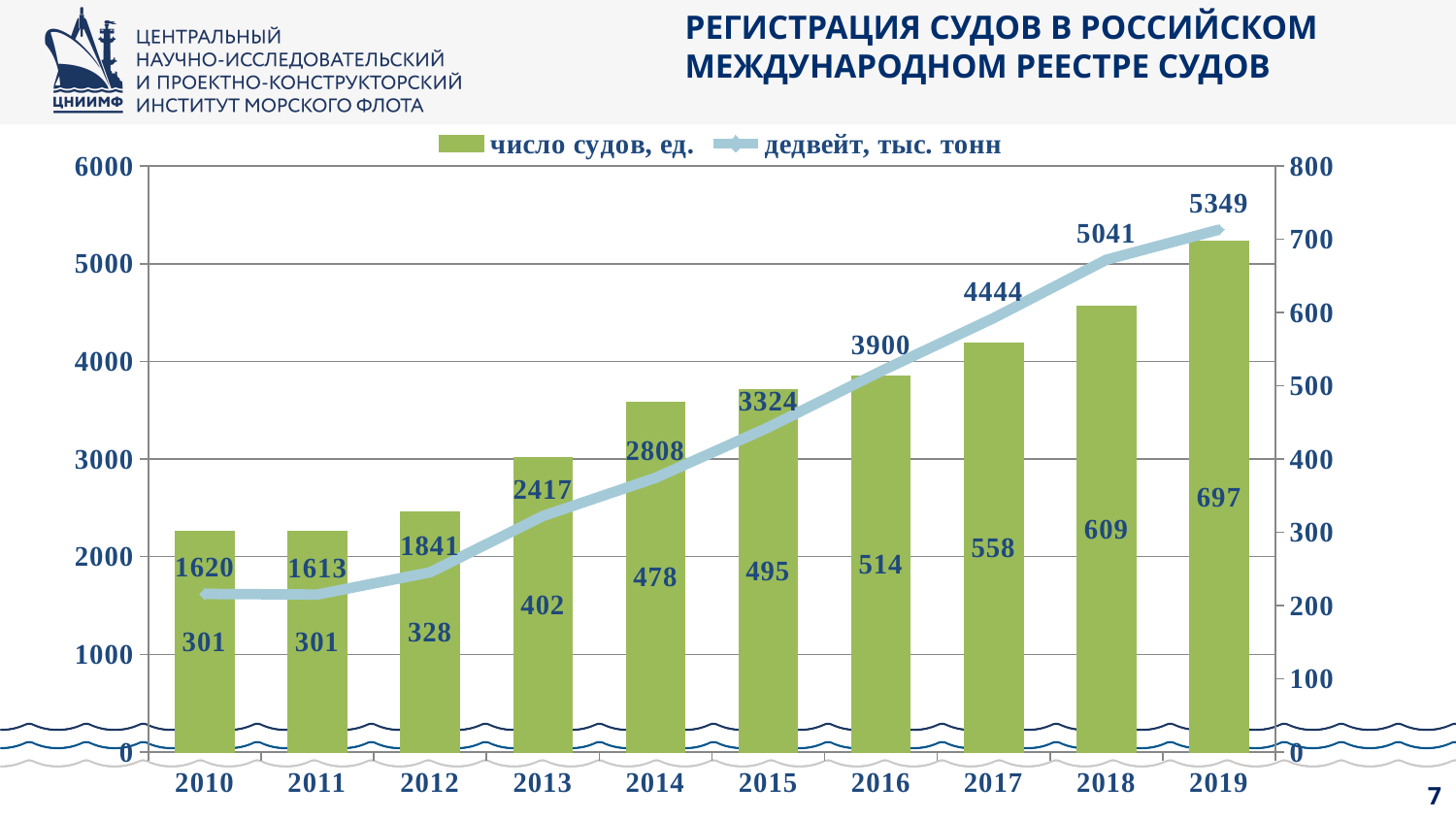
Which series is shown as a line rather than bars? дедвейт, тыс. тонн Does the deadweight (дедвейт, тыс. тонн) rise or fall from 2012 to 2019? rise Which year has the highest deadweight (дедвейт, тыс. тонн)? 2019 How many years are shown on the x axis? 10 Which is larger: the number of vessels in 2015 or in 2017? 2017 What is the difference in the number of vessels (число судов, ед.) between 2019 and 2018? 88 What is the difference in deadweight (дедвейт, тыс. тонн) between 2018 and 2017? 597 How many series does the legend list? 2 What is the number of vessels (число судов, ед.) in 2019? 697 What is the number of vessels (число судов, ед.) in 2013? 402 What is the deadweight (дедвейт, тыс. тонн) value for 2016? 3900 Which year has the lowest deadweight (дедвейт, тыс. тонн)? 2011